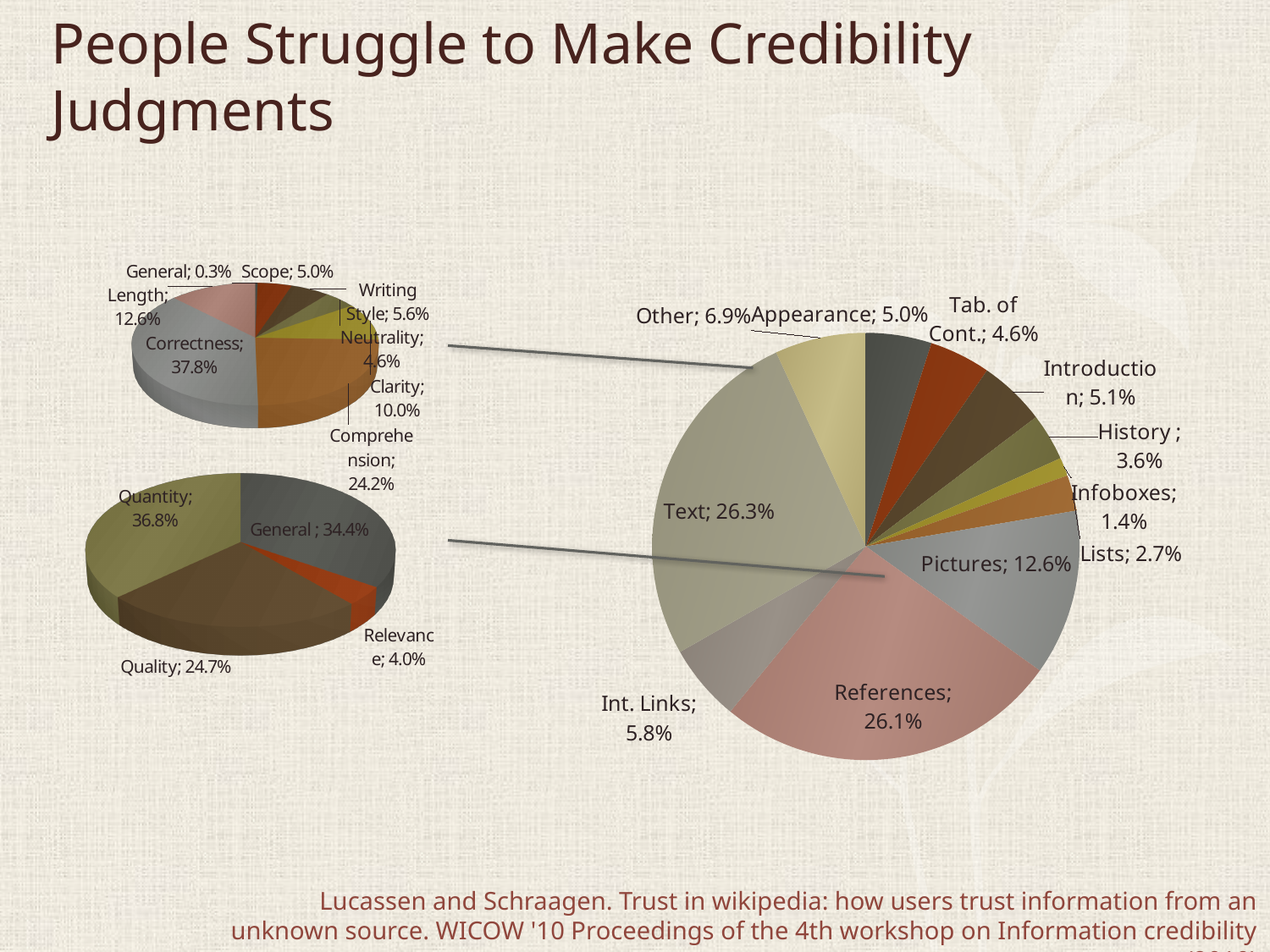
In the top-left pie chart, which category has the largest share? Correctness In the top-left pie chart, what share is labelled for Comprehension? 24.2% In the large pie chart on the right, which is larger: the share for Pictures or the share for Other? Pictures In the bottom-left pie chart, how many categories are shown? 4 In the large pie chart on the right, what share is labelled for Pictures? 12.6% In the bottom-left pie chart, what share is labelled for Quality? 24.7% In the large pie chart on the right, how many categories are shown? 11 In the top-left pie chart, which category has the smallest share? General In the large pie chart on the right, what is the difference between the shares for Pictures and Int. Links? 6.8% In the large pie chart on the right, which category has the smallest share? Infoboxes In the large pie chart on the right, what share is labelled for Text? 26.3% What kind of chart is the large chart on the right of the slide? Pie chart